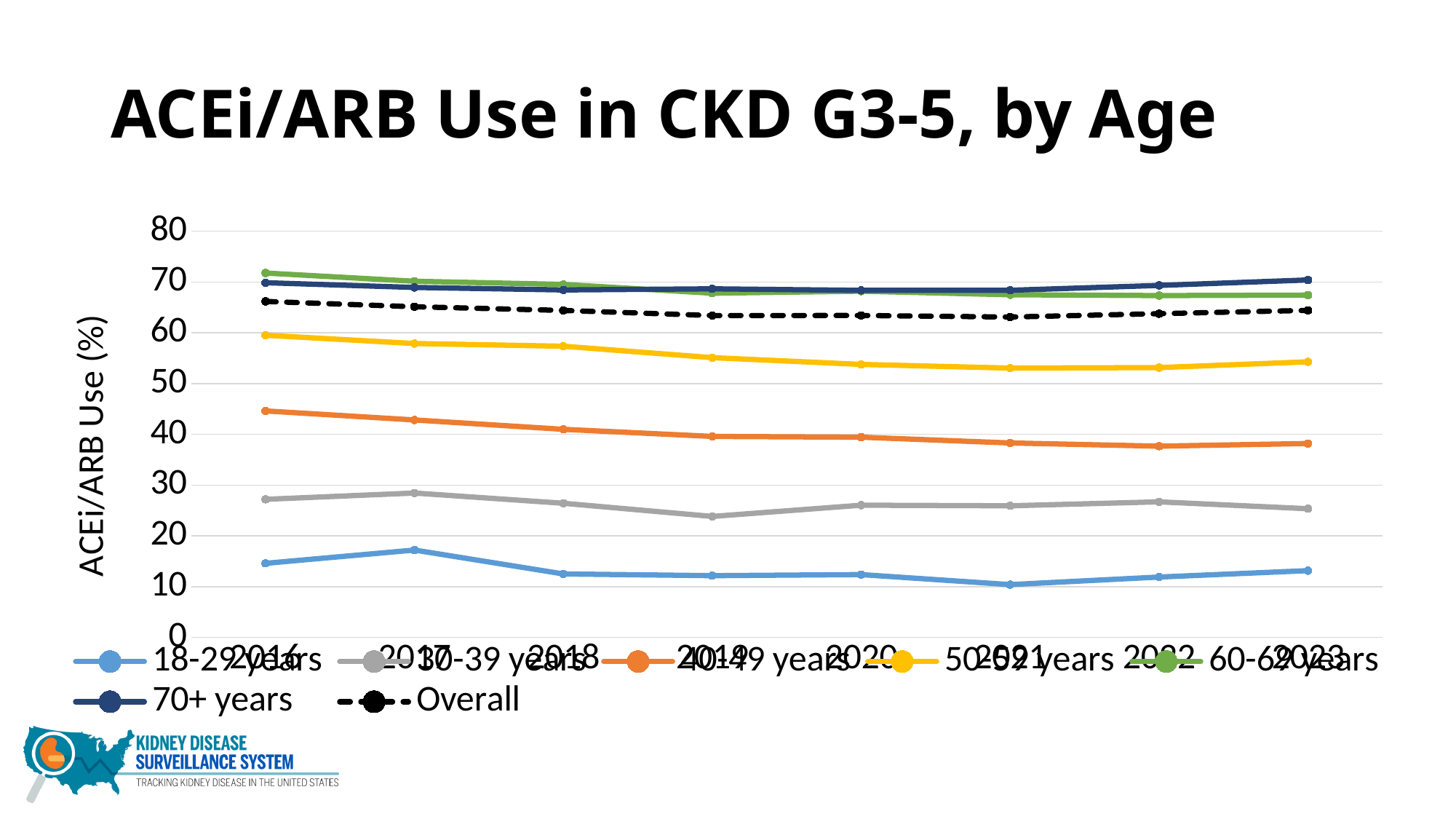
In 2020, which is larger: the value for 40-49 years or the value for 50-59 years? 50-59 years How many years are plotted along the x axis? 8 Is the value for 40-49 years in 2016 greater or less than 40? greater Which age group has the lowest ACEi/ARB use across all years? 18-29 years Does the value for 40-49 years rise or fall from 2016 to 2023? fall Is the value for 30-39 years in 2019 greater or less than 30? less Is the value for 50-59 years in 2021 greater or less than 50? greater Which series has the highest value in 2023? 70+ years What is the label on the y axis? ACEi/ARB Use (%) How many series does the legend list? 7 What kind of chart is shown on the slide? line chart